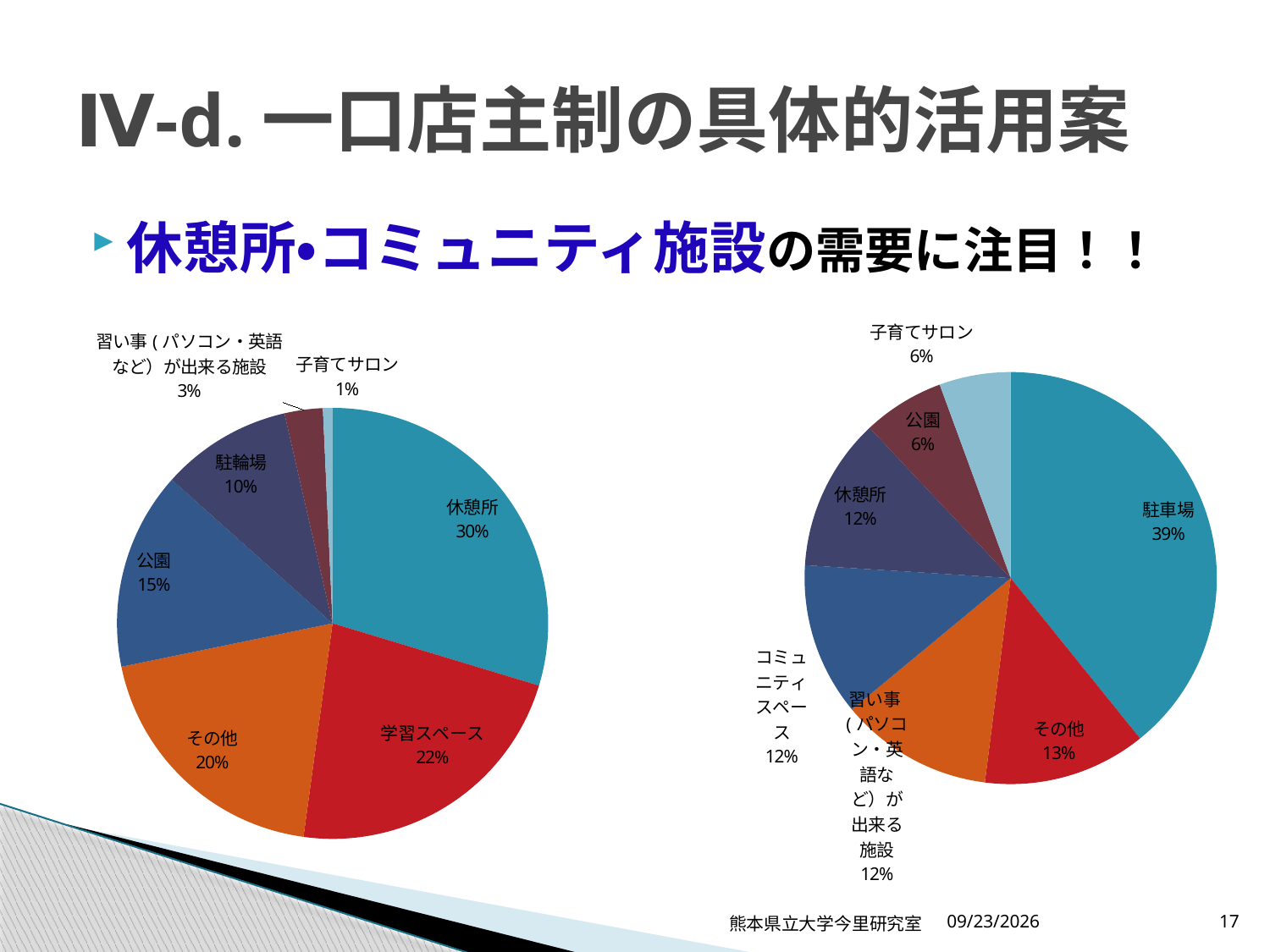
In the left pie chart, which category has the smallest share? 子育てサロン In the left pie chart, what share does 休憩所 have? 30% In the right pie chart, what share does 休憩所 have? 12% In the left pie chart, how many categories are shown? 7 In the left pie chart, what share does 学習スペース have? 22% In the right pie chart, which is larger, その他 or 公園? その他 What type of chart is shown on the left of the slide? Pie chart In the left pie chart, which category has the largest share? 休憩所 In the left pie chart, what is the difference between the shares of 公園 and 駐輪場? 5% In the right pie chart, how many categories are shown? 7 In the right pie chart, what share does 駐車場 have? 39% In the right pie chart, which category has the largest share? 駐車場